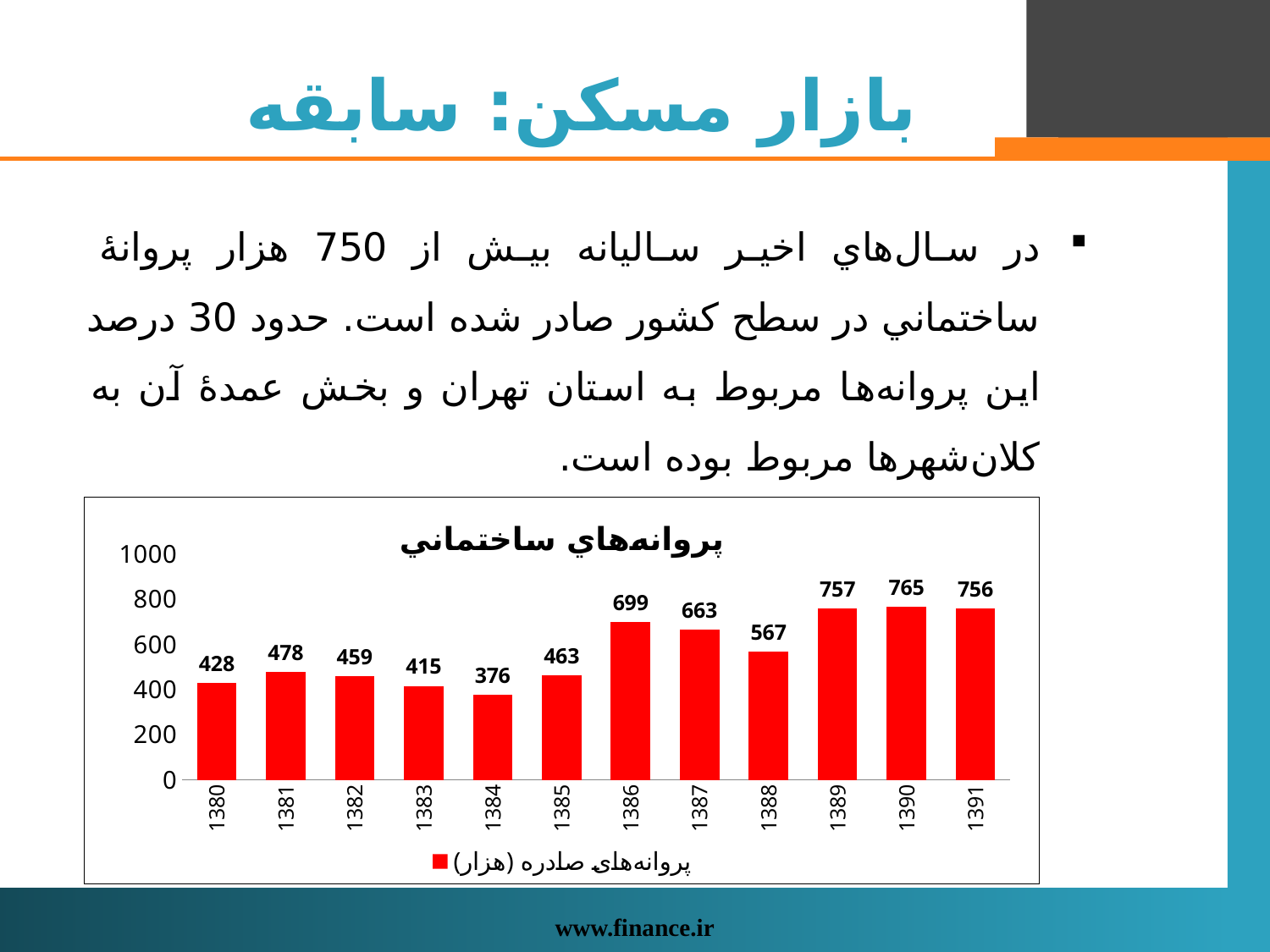
What is the value for 1384? 376 What is the difference between the values for 1390 and 1384? 389 Which is larger, the value for 1381 or the value for 1383? 1381 Which year has the lowest value? 1384 How many years are shown on the x axis? 12 Which year has the highest value? 1390 Is the value for 1388 greater or less than 600? less What is the value for 1386? 699 What is the title of the chart? پروانه‌هاي ساختماني What is the value for 1391? 756 What kind of chart is shown on the slide? bar chart What is the difference between the values for 1386 and 1387? 36